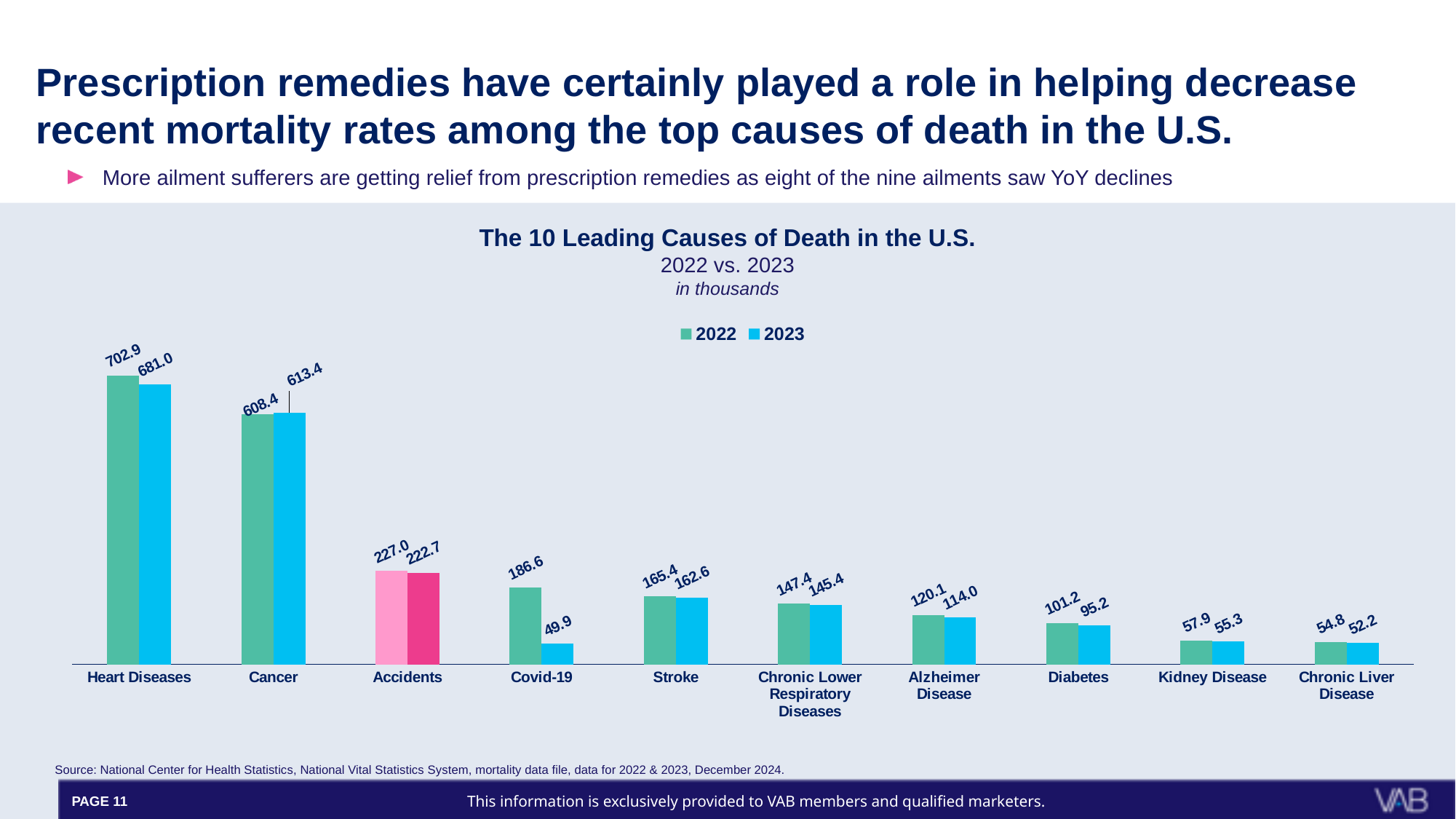
Which cause of death has the lowest 2022 value? Chronic Liver Disease For Cancer, which year has the larger value, 2022 or 2023? 2023 Which cause of death has the highest 2023 value? Heart Diseases What is the 2022 value for Heart Diseases? 702.9 What is the 2022 value for Kidney Disease? 57.9 What is the 2023 value for Cancer? 613.4 What type of chart is shown on the slide? Bar chart What is the difference between the 2022 and 2023 values for Covid-19? 136.7 What is the difference between the 2022 and 2023 values for Heart Diseases? 21.9 How many causes of death are shown on the chart? 10 How many series does the legend list? 2 What is the 2023 value for Covid-19? 49.9